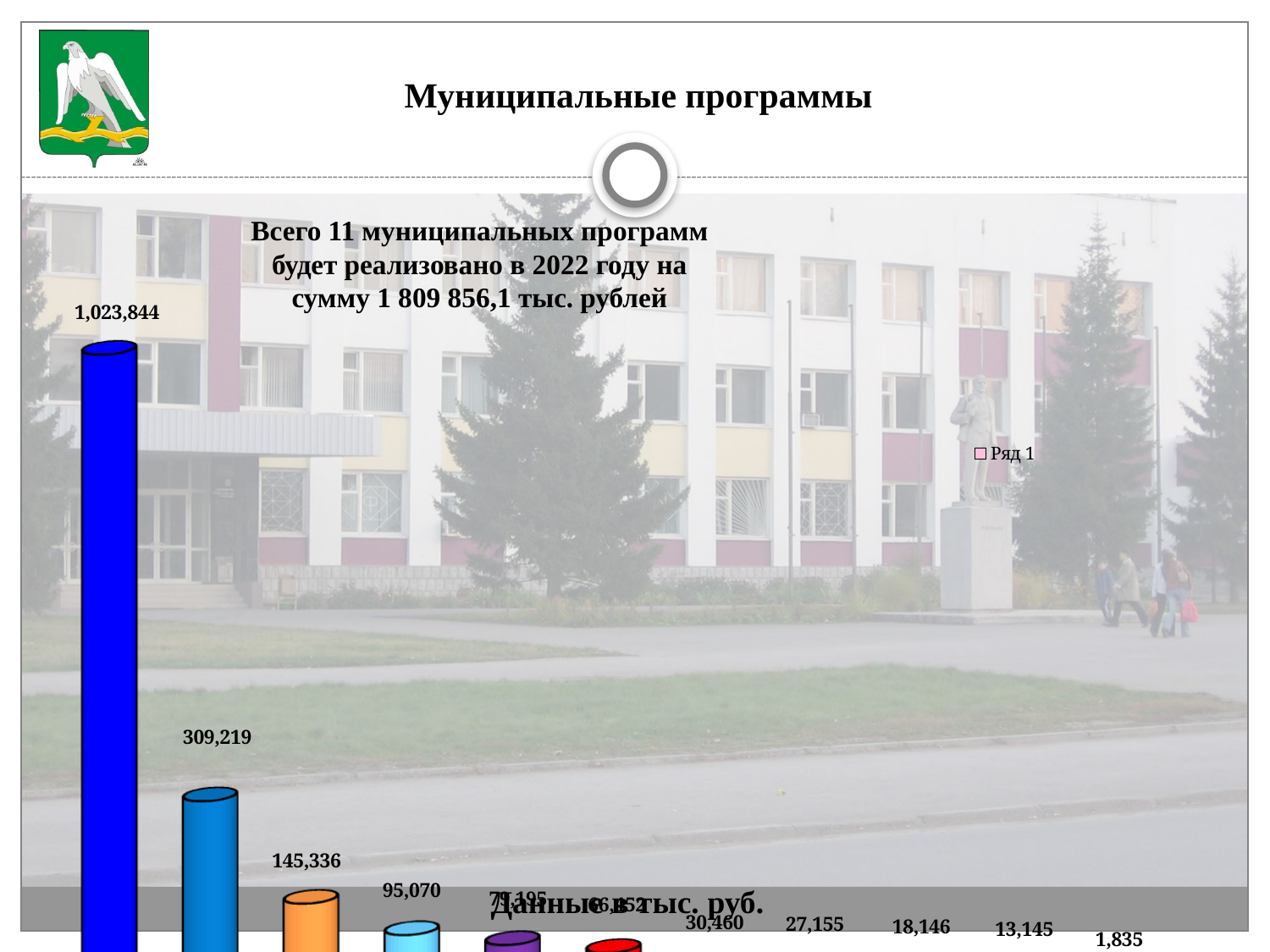
How many series does the chart legend list? 1 What kind of chart is shown on the slide? bar chart What is the difference between the values 309,219 and 145,336 on the chart? 163,883 What is the highest value labelled on the chart? 1,023,844 What is the value labelled on the third bar from the left? 145,336 What colour is the tallest bar on the chart? blue What is the lowest value labelled on the chart? 1,835 What is the difference between the tallest bar (1,023,844) and the second tallest bar (309,219)? 714,625 What is the value labelled on the fourth bar from the left? 95,070 What is the value labelled on the second bar from the left? 309,219 What is the name of the series shown in the chart legend? Ряд 1 Do the bar values rise or fall from left to right across the chart? fall